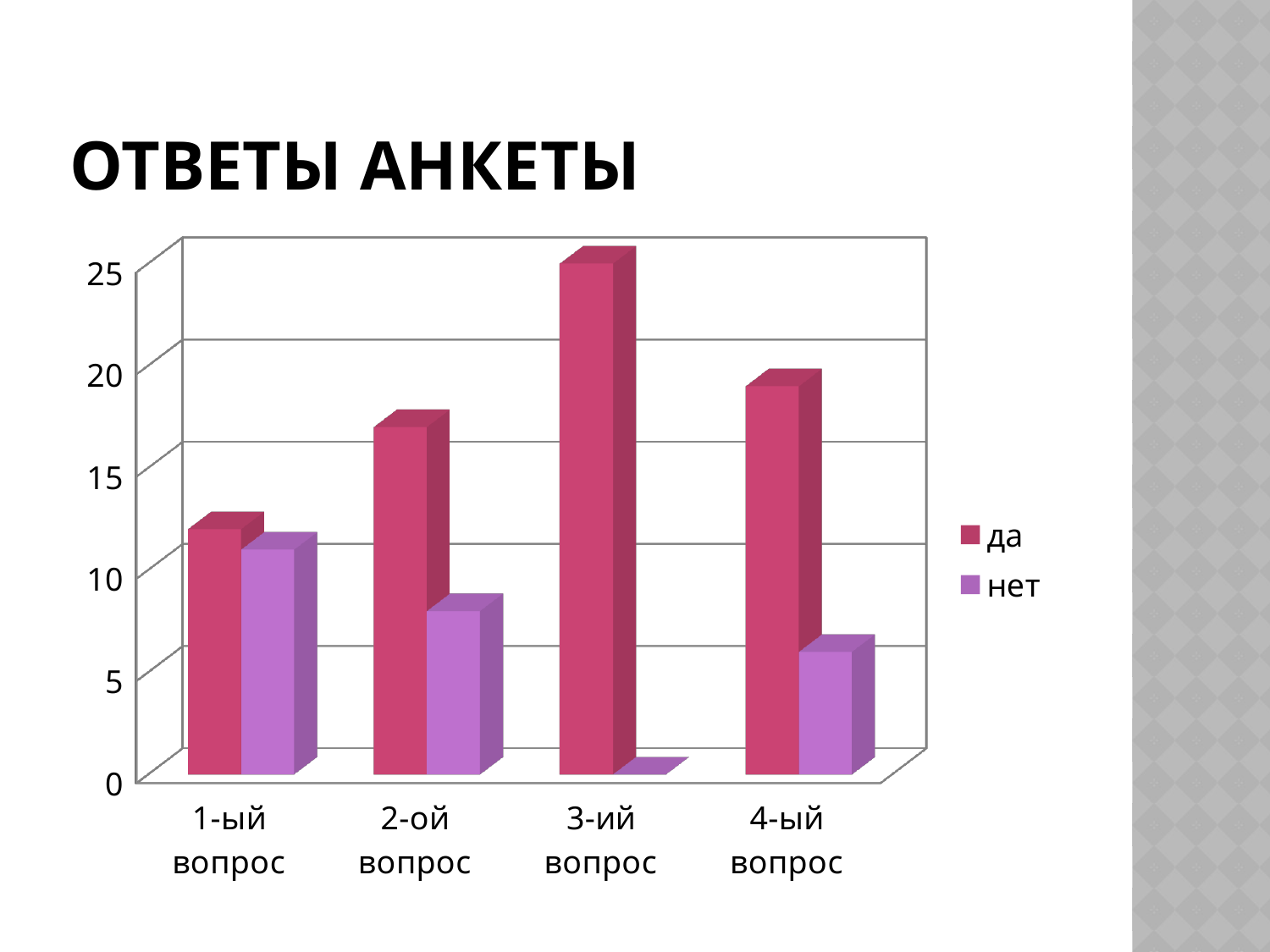
Which series is shown in purple in the legend? нет Is the 'нет' value for 2-ой вопрос greater or less than 10? less How many series does the legend list? 2 What kind of chart is shown on the slide? bar chart For 4-ый вопрос, which is larger, the 'да' value or the 'нет' value? да For which question is the 'да' value highest? 3-ий вопрос Is the 'да' value for 3-ий вопрос greater or less than 20? greater For which question is the 'да' value lowest? 1-ый вопрос For which question is the 'нет' value lowest? 3-ий вопрос How many question categories are shown on the x axis? 4 What is the title of the slide? ОТВЕТЫ АНКЕТЫ For which question is the 'нет' value highest? 1-ый вопрос